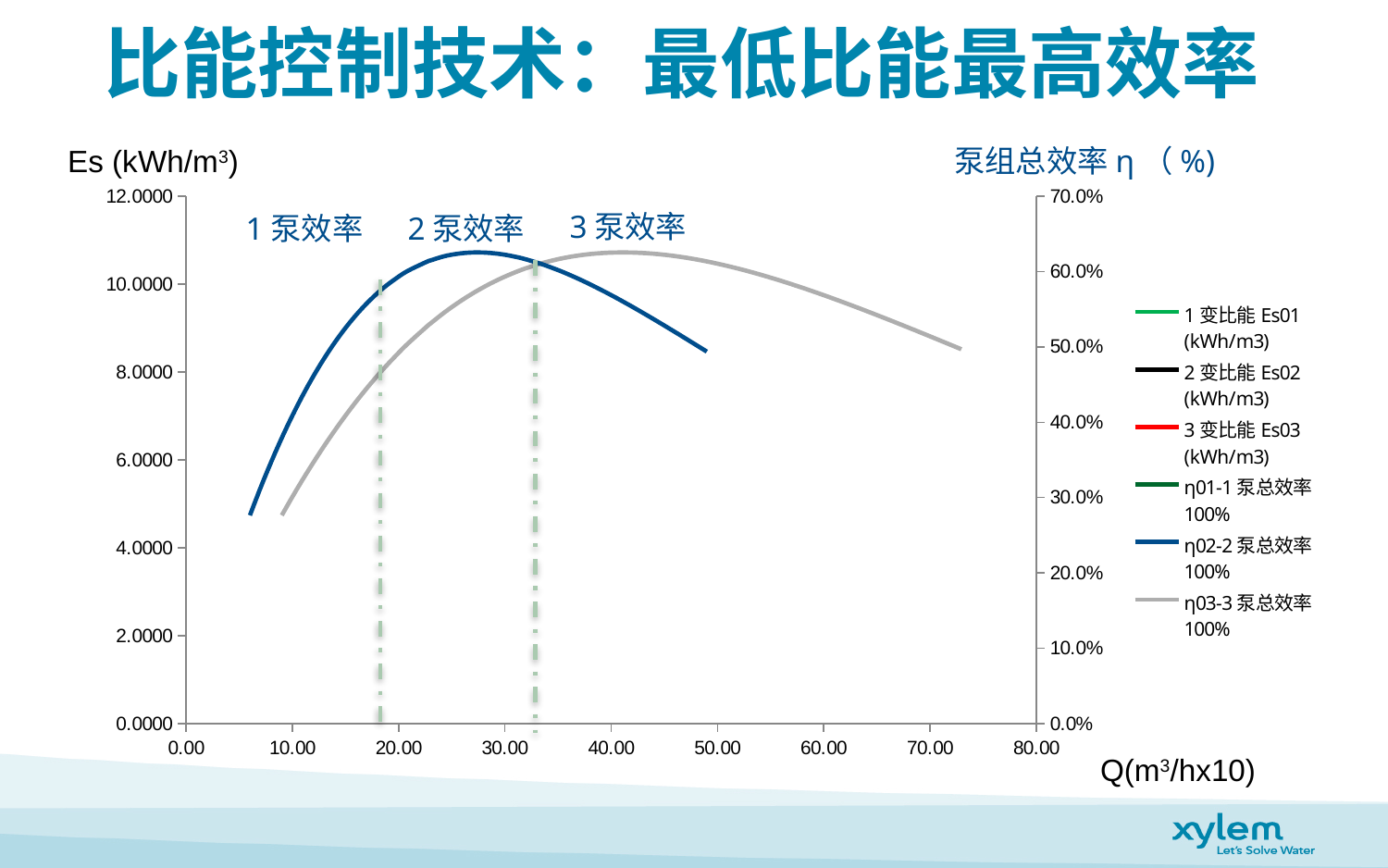
Is the value of the grey curve at Q = 10.00 greater or less than 6.0000 on the left axis? less What kind of chart is shown on the slide? line chart Does the grey curve rise or fall as Q increases from 10.00 to 30.00? rise Which curve reaches its peak at a larger Q value, the blue curve or the grey curve? the grey curve Is the value of the grey curve at Q = 70.00 greater or less than 8.0000 on the left axis? greater Is the peak of the blue curve greater or less than 10.0000 on the left axis? greater What is the title of the slide? 比能控制技术：最低比能最高效率 How many series does the legend list? 6 Which curve extends to a larger maximum Q value, the blue curve or the grey curve? the grey curve What is the label of the right-hand vertical axis? 泵组总效率 η （%） Does the blue curve rise or fall as Q increases from 30.00 to 50.00? fall